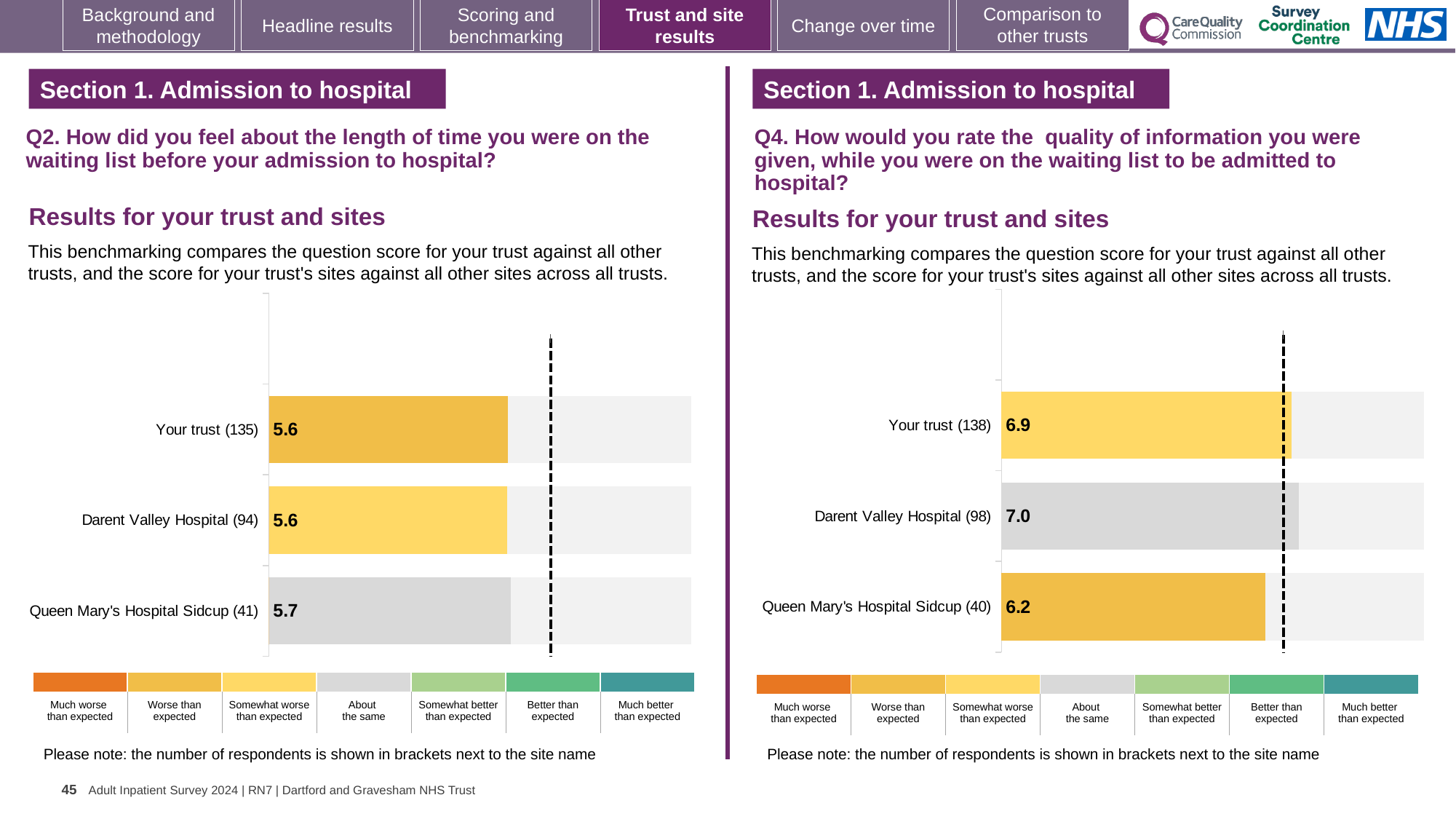
On the Q4 chart (right), what is the score for Queen Mary's Hospital Sidcup? 6.2 On the Q2 chart (left), what is the difference between the scores for Queen Mary's Hospital Sidcup and Your trust? 0.1 On the Q4 chart (right), what is the difference between the scores for Darent Valley Hospital and Queen Mary's Hospital Sidcup? 0.8 On the Q4 chart (right), what is the score for Darent Valley Hospital? 7.0 On the Q4 chart (right), which site or trust has the lowest score? Queen Mary's Hospital Sidcup On the Q2 chart (left), how many respondents are shown in brackets for Darent Valley Hospital? 94 On the Q2 chart (left), what is the score for Your trust? 5.6 On the Q2 chart (left), what is the score for Queen Mary's Hospital Sidcup? 5.7 On the Q4 chart (right), which has the larger score, Your trust or Queen Mary's Hospital Sidcup? Your trust On the Q4 chart (right), which site or trust has the highest score? Darent Valley Hospital What type of chart is used on the Q4 chart (right)? Bar chart How many bars are plotted on the Q2 chart (left)? 3